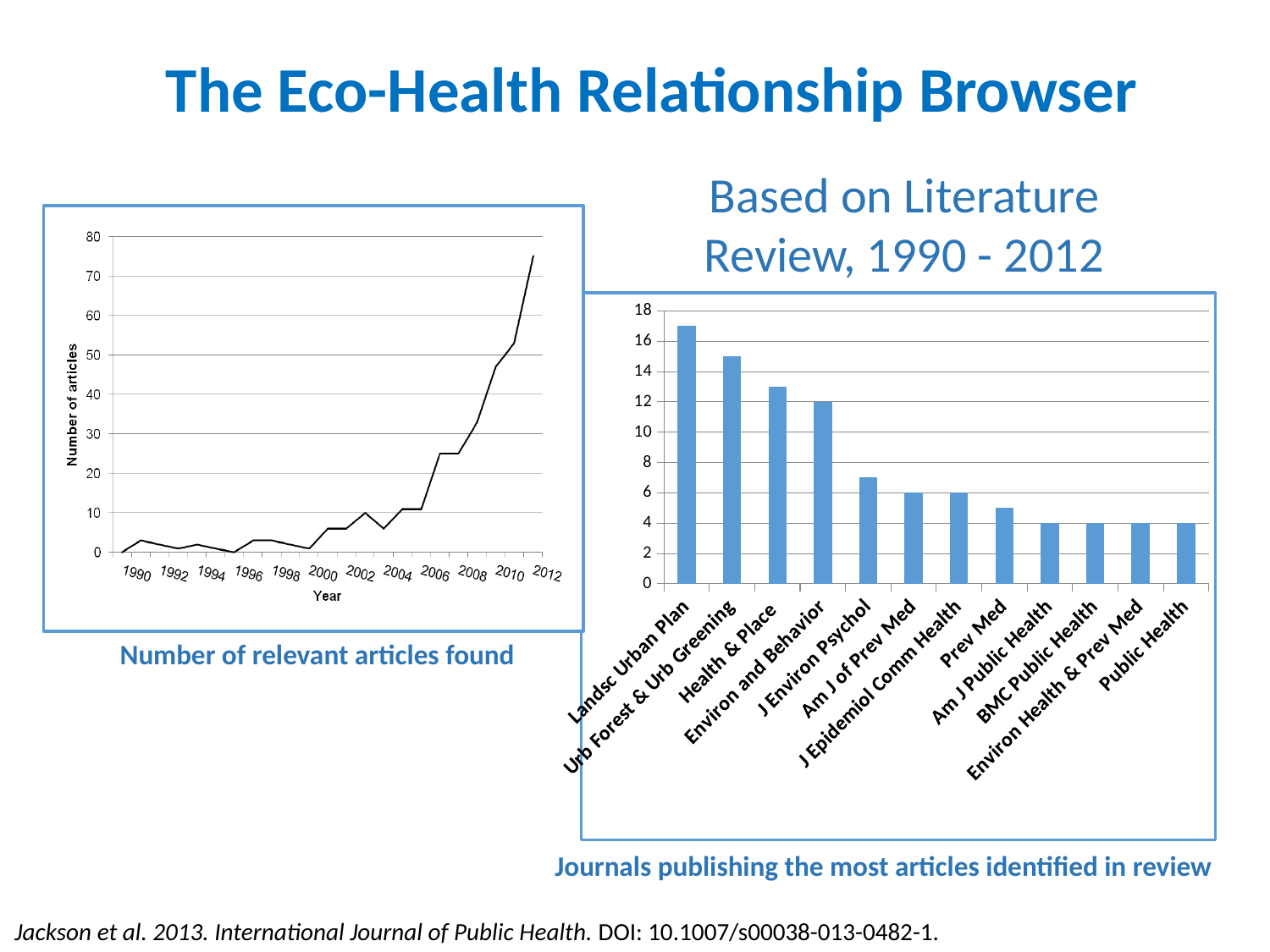
In the chart titled 'Journals publishing the most articles identified in review', which journal has the highest bar? Landsc Urban Plan In the chart titled 'Journals publishing the most articles identified in review', is the value for Landsc Urban Plan greater or less than 16? greater In the chart titled 'Journals publishing the most articles identified in review', which is larger, the value for Urb Forest & Urb Greening or the value for J Environ Psychol? Urb Forest & Urb Greening In the chart titled 'Journals publishing the most articles identified in review', what is the value for BMC Public Health? 4 How many journals are shown in the chart titled 'Journals publishing the most articles identified in review'? 12 In the chart titled 'Journals publishing the most articles identified in review', is the value for Health & Place greater or less than 14? less In the chart titled 'Number of relevant articles found', is the value for 2012 greater or less than 70? greater In the chart titled 'Journals publishing the most articles identified in review', what is the value for Am J of Prev Med? 6 In the chart titled 'Journals publishing the most articles identified in review', what is the difference between the values for Environ and Behavior and J Epidemiol Comm Health? 6 In the chart titled 'Journals publishing the most articles identified in review', what is the value for Environ and Behavior? 12 In the chart titled 'Number of relevant articles found', do the values generally rise or fall from 1990 to 2012? rise What kind of chart is the chart titled 'Journals publishing the most articles identified in review'? bar chart